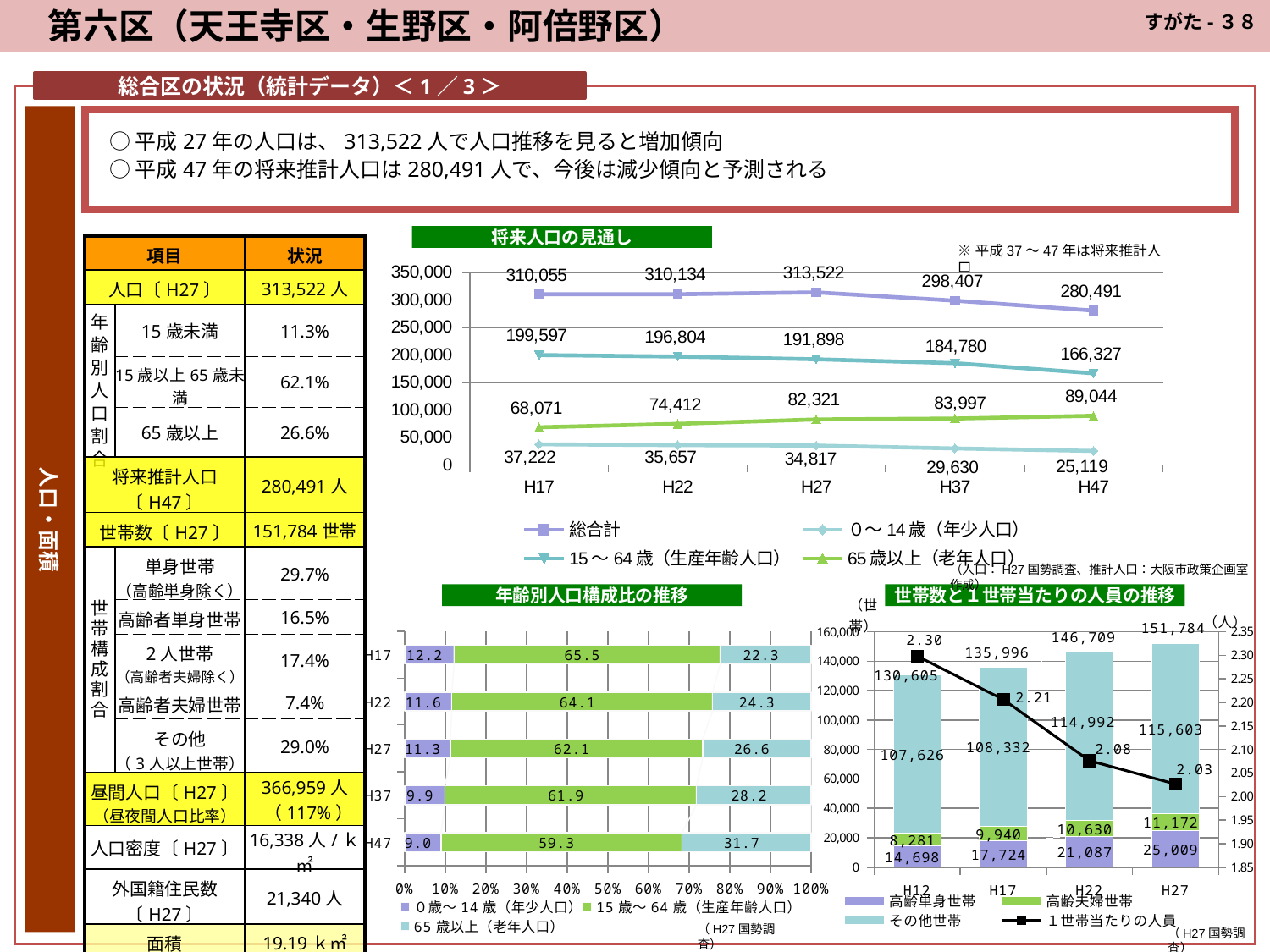
In the 将来人口の見通し chart, at which year is the 総合計 value highest? H27 In the 世帯数と1世帯当たりの人員の推移 chart, what is the 1世帯当たりの人員 value for H27? 2.03 In the 将来人口の見通し chart, does the 65歳以上（老年人口） series rise or fall from H17 to H47? rise In the 将来人口の見通し chart, what is the difference between the 総合計 values for H27 and H47? 33,031 In the 年齢別人口構成比の推移 chart, what is the 15～64歳（生産年齢人口） share for H27? 62.1 In the 年齢別人口構成比の推移 chart, how many years (bars) are shown? 5 In the 将来人口の見通し chart, what is the 総合計 value for H27? 313,522 In the 年齢別人口構成比の推移 chart, what is the 65歳以上（老年人口） share for H47? 31.7 What kind of chart is the 年齢別人口構成比の推移 chart? stacked bar chart In the 将来人口の見通し chart, how many series does the legend list? 4 In the 世帯数と1世帯当たりの人員の推移 chart, what is the 高齢単身世帯 value for H27? 25,009 In the 将来人口の見通し chart, what is the 65歳以上（老年人口） value for H47? 89,044